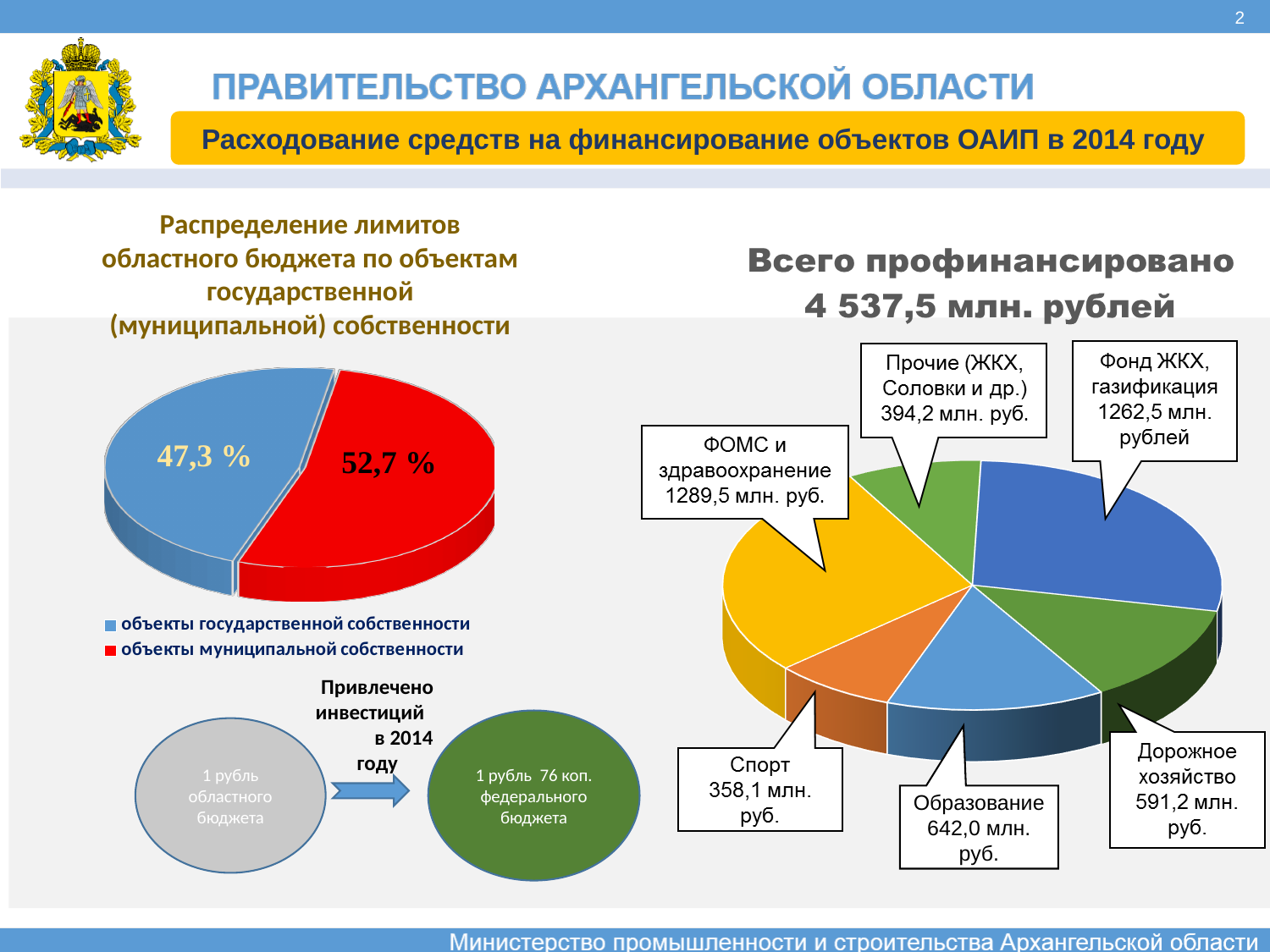
On the right pie chart (Всего профинансировано), how many categories are shown? 6 On the left pie chart (Распределение лимитов областного бюджета), what share is shown for объекты государственной собственности? 47,3 % What type of chart is used on the right side of the slide (Всего профинансировано)? pie chart On the left pie chart (Распределение лимитов областного бюджета), what colour is the slice for объекты государственной собственности? blue On the right pie chart (Всего профинансировано), which category has the largest amount? ФОМС и здравоохранение On the left pie chart (Распределение лимитов областного бюджета), which category has the larger share? объекты муниципальной собственности On the left pie chart (Распределение лимитов областного бюджета), by how many percentage points does the municipal share exceed the state share? 5,4 On the right pie chart (Всего профинансировано), what amount is shown for Дорожное хозяйство? 591,2 млн. руб. On the right pie chart (Всего профинансировано), which category has the smallest amount? Спорт On the right pie chart (Всего профинансировано), what amount is shown for Образование? 642,0 млн. руб. On the left pie chart (Распределение лимитов областного бюджета), what share is shown for объекты муниципальной собственности? 52,7 % On the right pie chart (Всего профинансировано), what is the difference between ФОМС и здравоохранение and Фонд ЖКХ, газификация? 27,0 млн. руб.